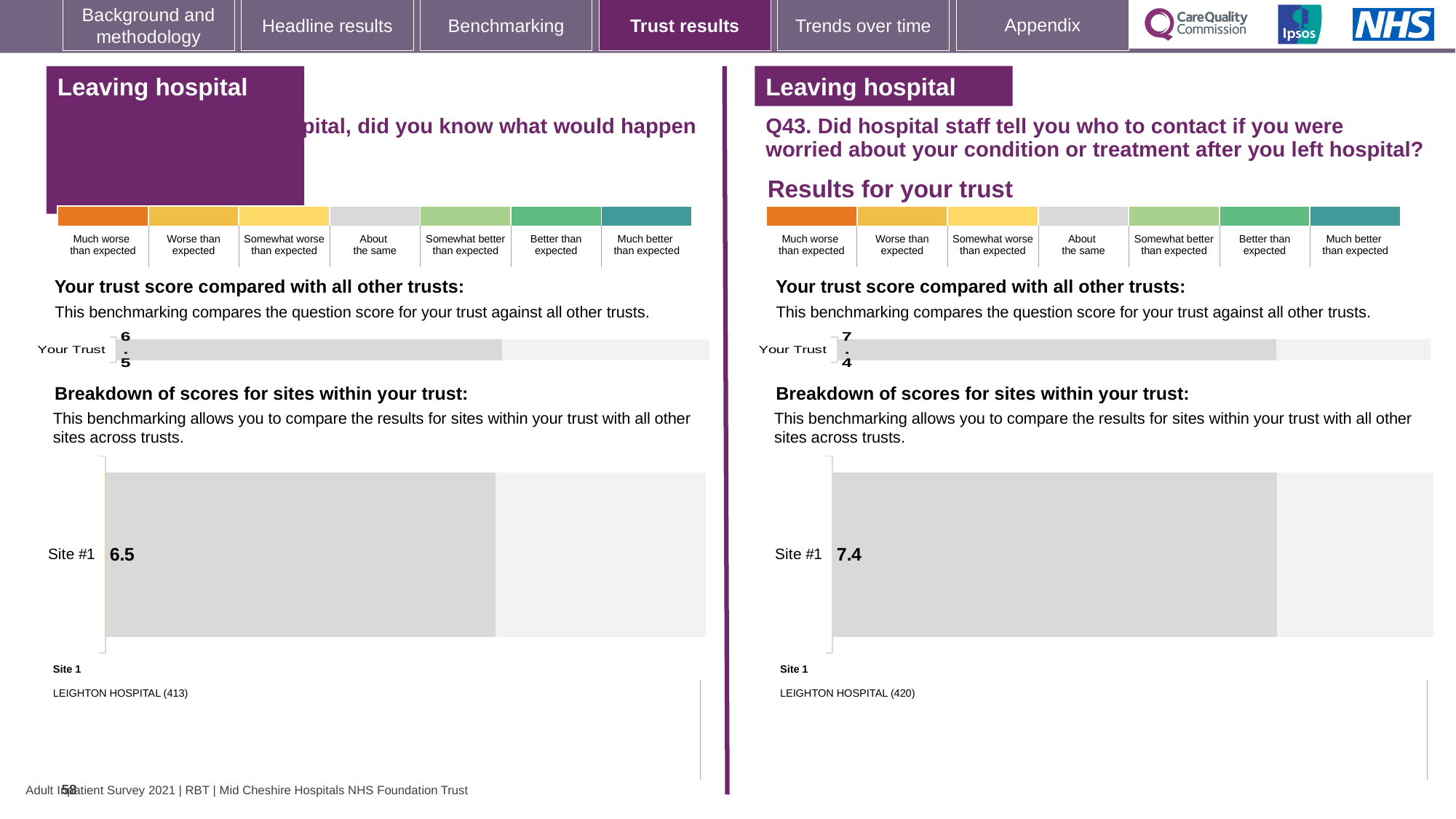
What kind of chart is the right-hand Q43 'Breakdown of scores for sites within your trust' chart? Bar chart On the right-hand Q43 'Your trust score compared with all other trusts' chart, what is the value shown for Your Trust? 7.4 How many sites are plotted on the left-hand 'Breakdown of scores for sites within your trust' chart? 1 How many sites are plotted on the right-hand Q43 'Breakdown of scores for sites within your trust' chart? 1 On the left-hand 'Your trust score compared with all other trusts' chart, what is the value shown for Your Trust? 6.5 What is the difference between the Your Trust score on the right-hand Q43 chart and the Your Trust score on the left-hand chart? 0.9 What is the category label of the single bar on the left-hand 'Breakdown of scores for sites within your trust' chart? Site #1 Which is larger: the Your Trust score on the left-hand chart or the Your Trust score on the right-hand Q43 chart? The right-hand Q43 chart (7.4) On the left-hand 'Breakdown of scores for sites within your trust' chart, what is the value for Site #1? 6.5 On the right-hand Q43 'Breakdown of scores for sites within your trust' chart, what is the value for Site #1? 7.4 According to the note below the right-hand Q43 breakdown chart, which hospital is Site 1? LEIGHTON HOSPITAL (420)